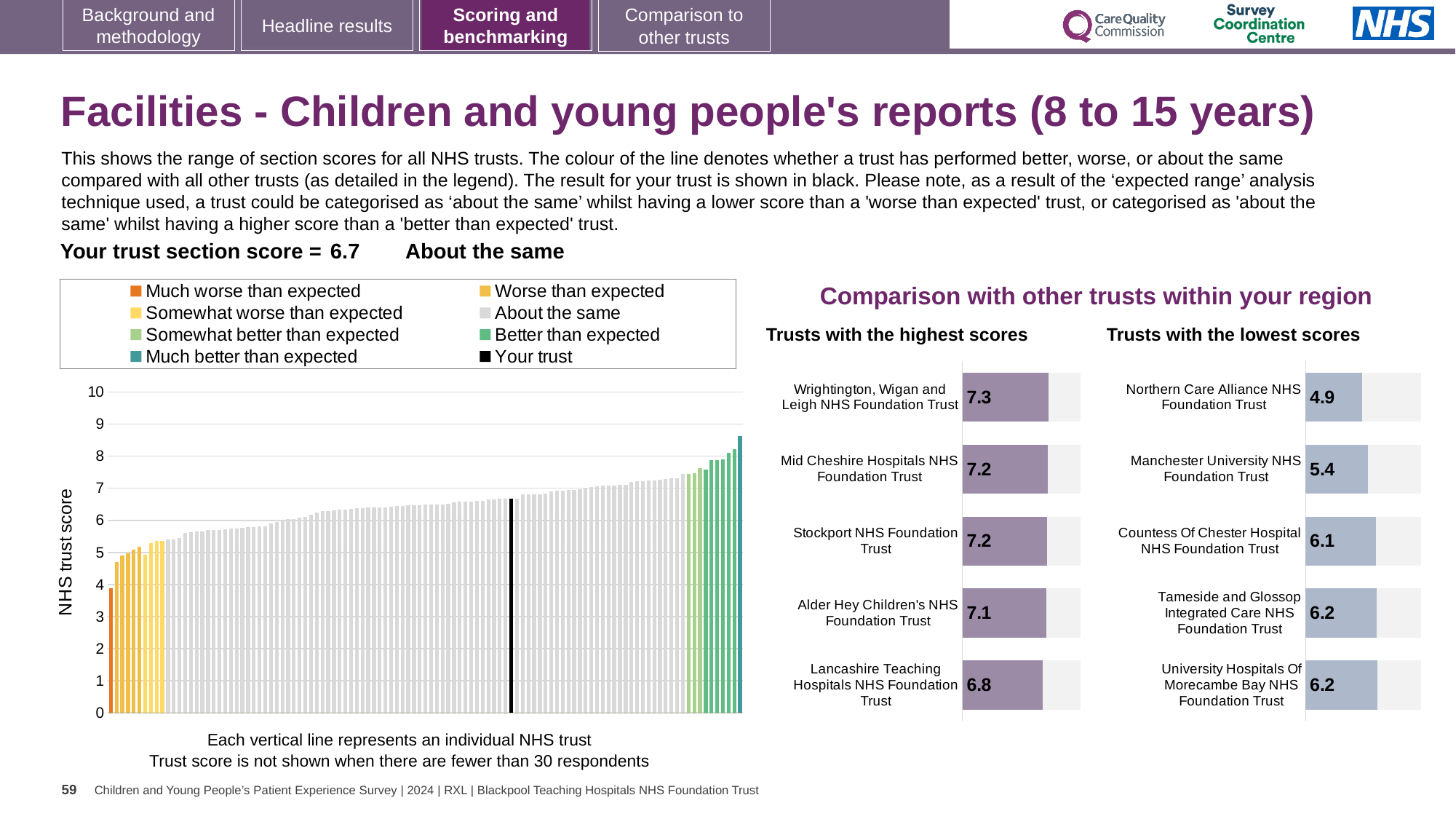
In the 'Trusts with the lowest scores' chart, what is the difference between the scores of Manchester University NHS Foundation Trust and Northern Care Alliance NHS Foundation Trust? 0.5 In the 'Trusts with the lowest scores' chart, which has the larger score: Manchester University NHS Foundation Trust or Countess Of Chester Hospital NHS Foundation Trust? Countess Of Chester Hospital NHS Foundation Trust In the 'Trusts with the highest scores' chart, what is the score for Wrightington, Wigan and Leigh NHS Foundation Trust? 7.3 In the large chart on the left showing the range of section scores, what kind of chart is it? Bar chart In the 'Trusts with the highest scores' chart, how many trusts are shown? 5 In the large chart on the left showing the range of section scores, is the value of the leftmost (lowest) bar greater or less than 5? less In the 'Trusts with the highest scores' chart, which trust has the lowest score? Lancashire Teaching Hospitals NHS Foundation Trust In the 'Trusts with the lowest scores' chart, what is the score for Northern Care Alliance NHS Foundation Trust? 4.9 In the 'Trusts with the highest scores' chart, what is the difference between the scores of Wrightington, Wigan and Leigh NHS Foundation Trust and Lancashire Teaching Hospitals NHS Foundation Trust? 0.5 In the large chart on the left showing the range of section scores, how many entries does the legend list? 8 In the 'Trusts with the lowest scores' chart, which trust has the lowest score? Northern Care Alliance NHS Foundation Trust In the large chart on the left showing the range of section scores, do the values rise or fall from left to right? Rise